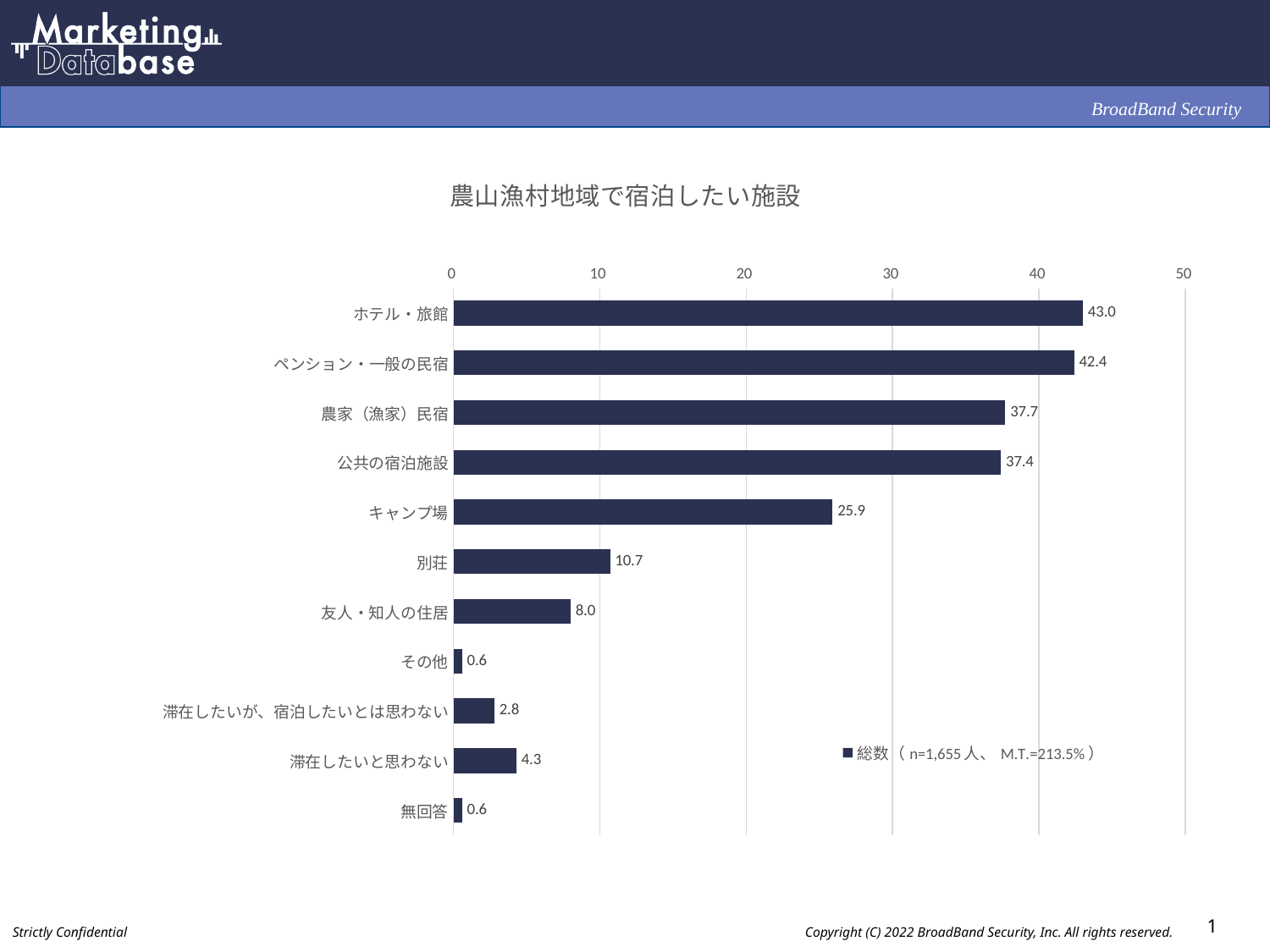
What is the value for 滞在したいと思わない? 4.3 Which category has the highest value? ホテル・旅館 What kind of chart is shown on the slide? bar chart What is the title of the chart? 農山漁村地域で宿泊したい施設 What is the difference between the values for キャンプ場 and 別荘? 15.2 Which is larger, the value for 農家（漁家）民宿 or 公共の宿泊施設? 農家（漁家）民宿 What is the value for ホテル・旅館? 43.0 What is the value for 友人・知人の住居? 8.0 How many categories are shown in the chart? 11 What is the difference between the values for ホテル・旅館 and ペンション・一般の民宿? 0.6 Is the value for 別荘 greater or less than 10? greater What is the value for キャンプ場? 25.9